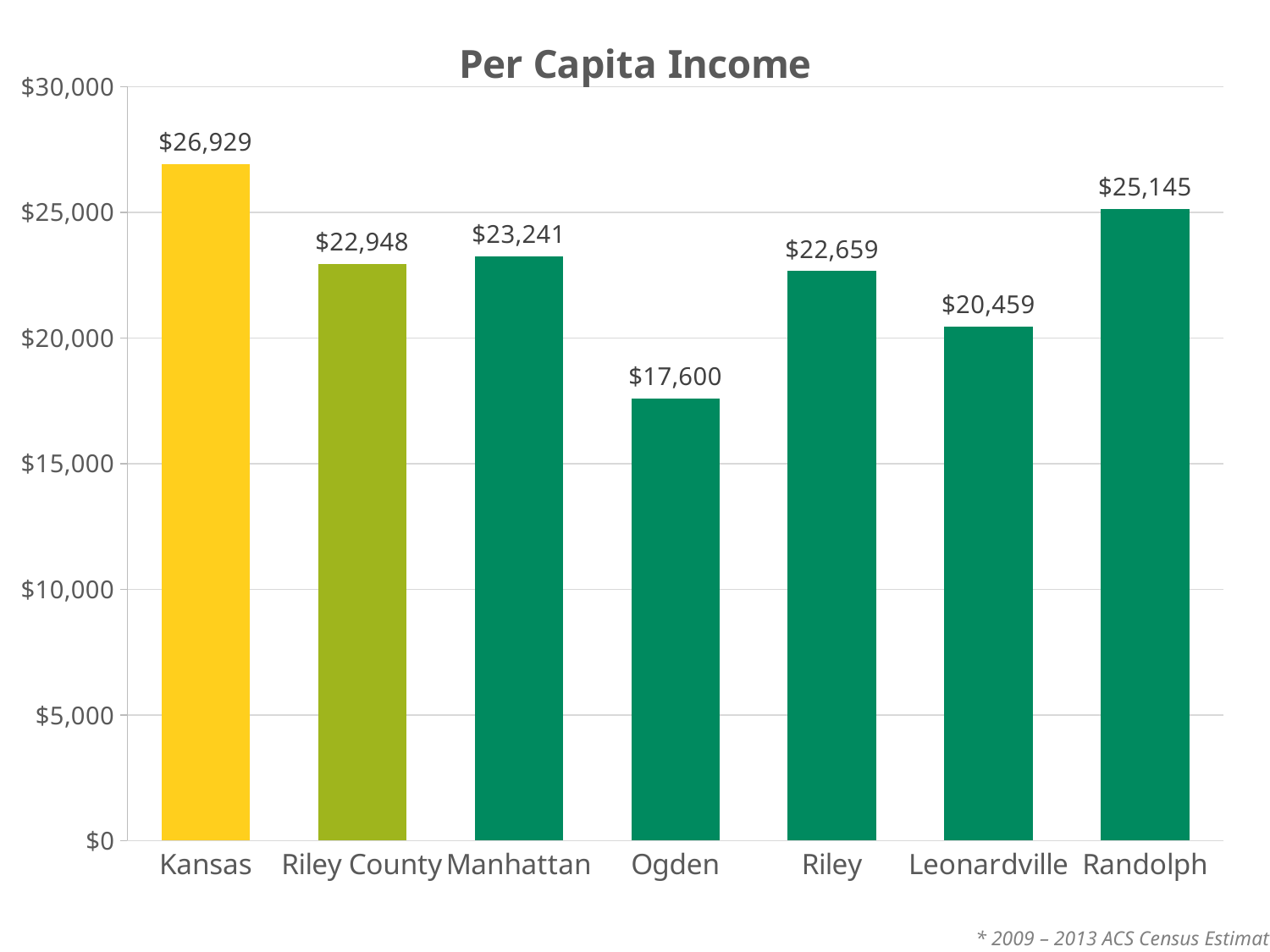
What kind of chart is shown on the slide? Bar chart What is the difference between the per capita income of Kansas and Riley County? $3,981 What is the per capita income for Leonardville? $20,459 What is the per capita income for Ogden? $17,600 What is the per capita income for Kansas? $26,929 How many categories are shown in the chart? 7 Which category has the highest per capita income? Kansas What is the per capita income for Randolph? $25,145 Which category has the lowest per capita income? Ogden What is the title of the chart? Per Capita Income Which has a higher per capita income, Manhattan or Leonardville? Manhattan What is the difference between the per capita income of Randolph and Ogden? $7,545